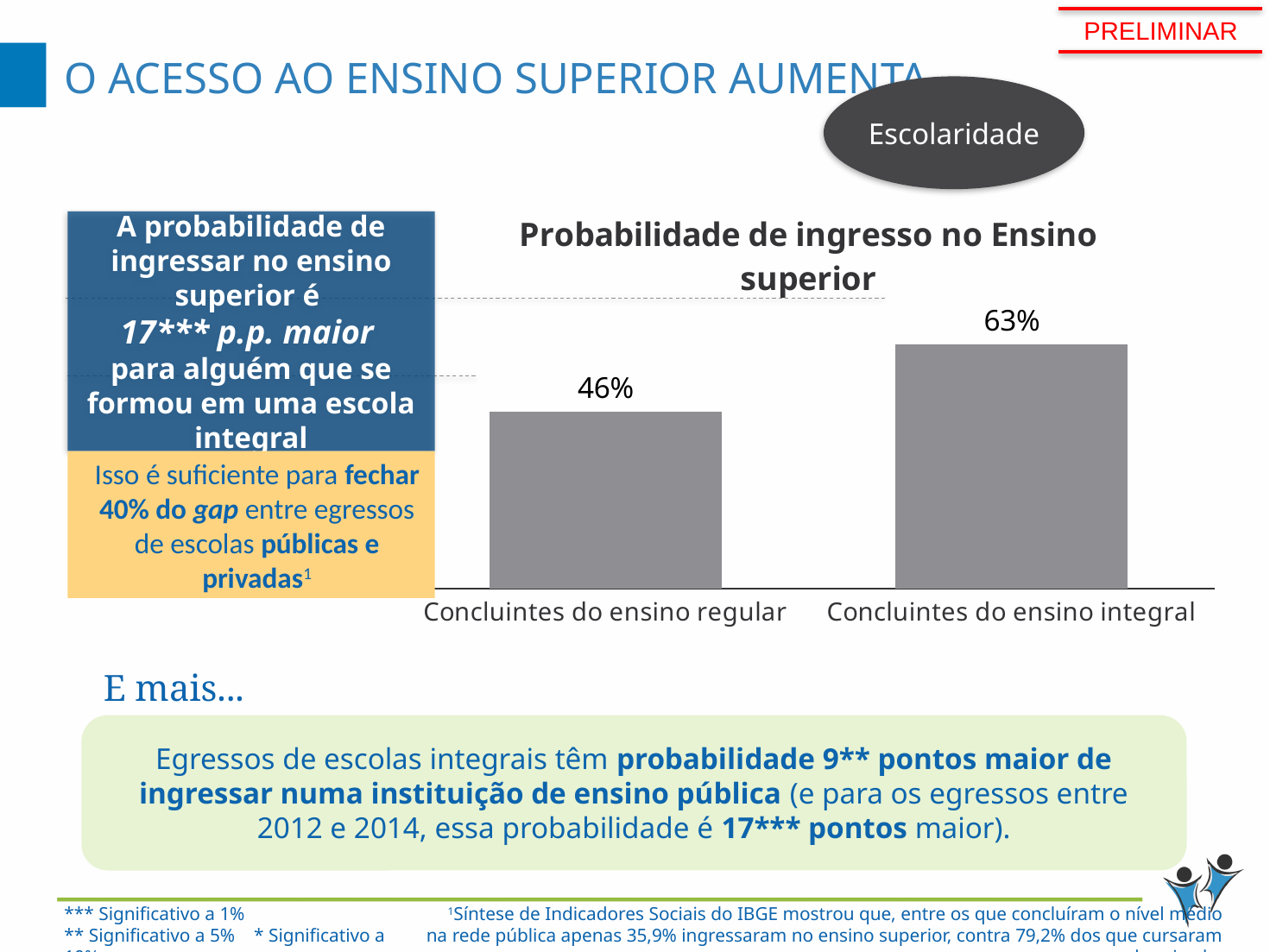
What is the difference between the values for Concluintes do ensino integral and Concluintes do ensino regular? 17 p.p. What kind of chart is shown on the slide? Bar chart What is the value for Concluintes do ensino regular? 46% How many categories are shown in the chart? 2 Which category has the highest value? Concluintes do ensino integral Which category has the lowest value? Concluintes do ensino regular What is the value for Concluintes do ensino integral? 63% What colour are the bars in the chart? Grey Which is larger, the value for Concluintes do ensino regular or for Concluintes do ensino integral? Concluintes do ensino integral Do the values rise or fall from left to right along the x axis? Rise What is the title of the chart? Probabilidade de ingresso no Ensino superior